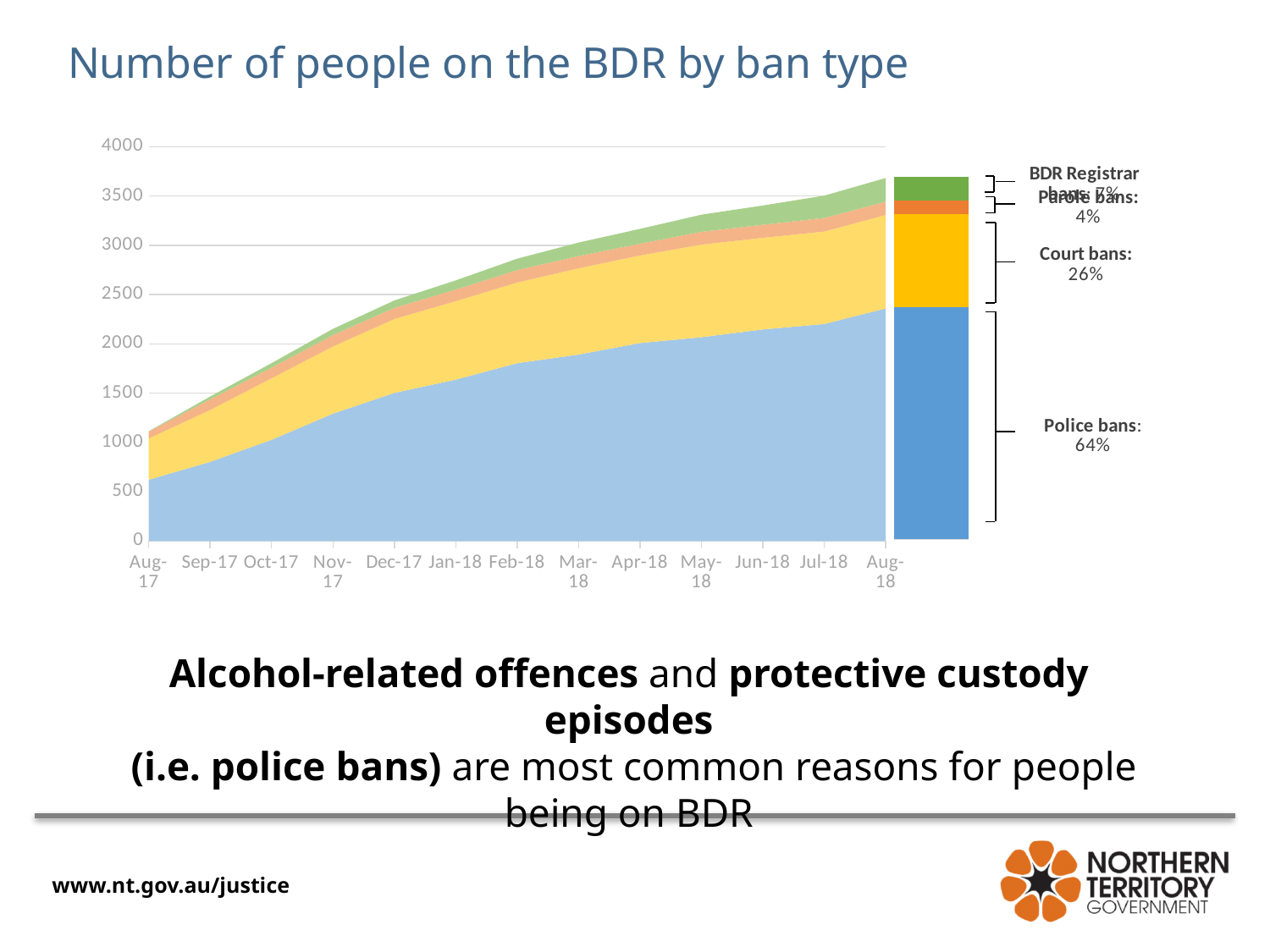
Does the total number of people on the BDR rise or fall from Aug-17 to Aug-18? Rise Is the total number of people on the BDR in Aug-17 greater or less than 1500? less Which ban type accounts for the largest share of people on the BDR in Aug-18? Police bans Which ban type accounts for the smallest share of people on the BDR in Aug-18? Parole bans What is the difference in percentage points between the police bans share and the court bans share in Aug-18? 38 What is the title of the chart? Number of people on the BDR by ban type Which is larger in Aug-18, the share of court bans or the share of parole bans? Court bans Is the total number of people on the BDR in Aug-18 greater or less than 3500? greater How many months are shown along the x axis of the chart? 13 What share of people on the BDR in Aug-18 are on police bans? 64% What share of people on the BDR in Aug-18 are on court bans? 26% What share of people on the BDR in Aug-18 are on parole bans? 4%